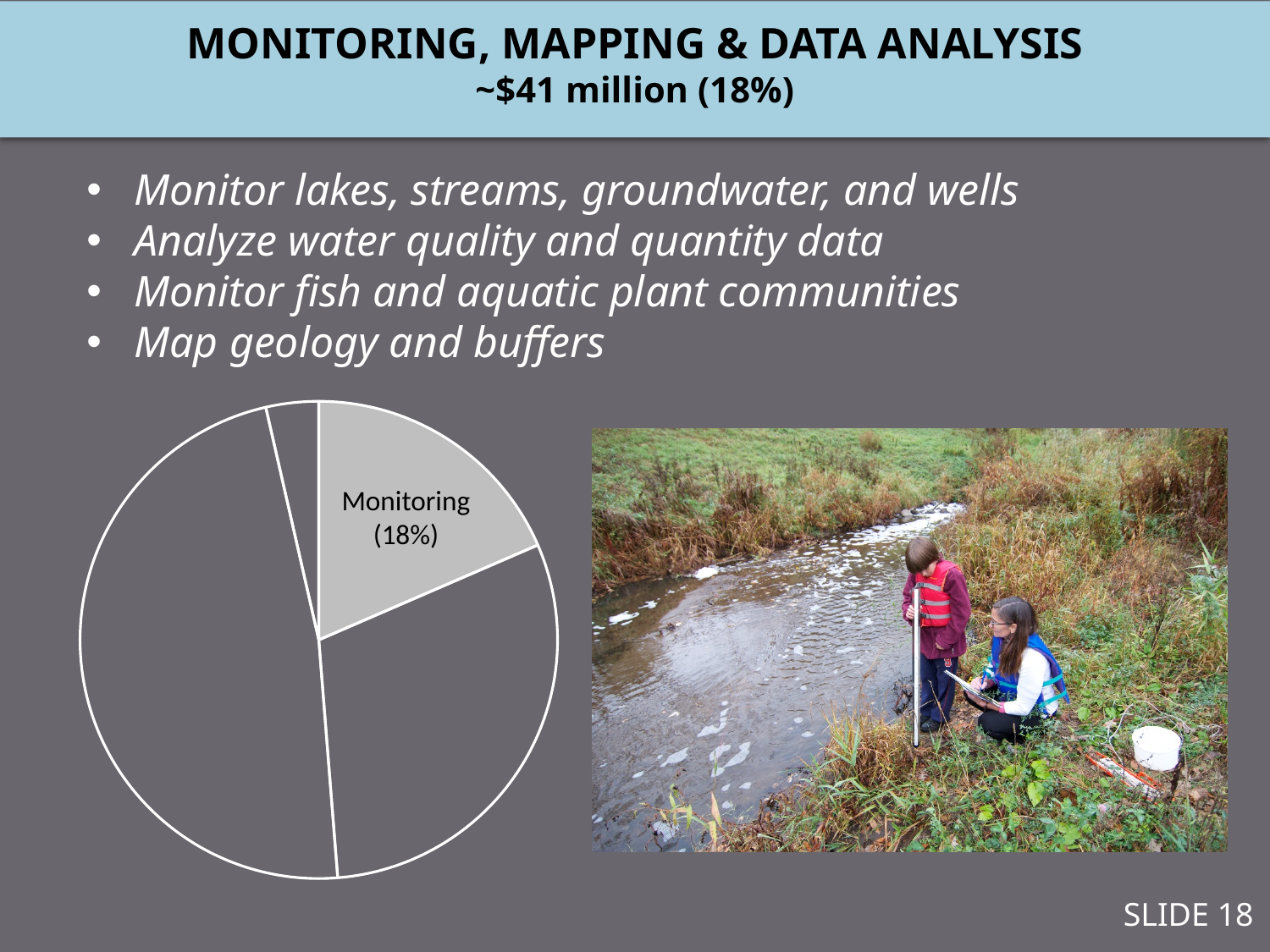
How many slices does the pie chart have? 4 What colour is the Monitoring slice in the pie chart? light grey Which slice of the pie chart is labeled? Monitoring How many slices in the pie chart have a printed percentage label? 1 Is the Monitoring slice the largest slice in the pie chart? No What kind of chart is shown on the slide? pie chart What share of the pie chart does the Monitoring slice represent? 18%